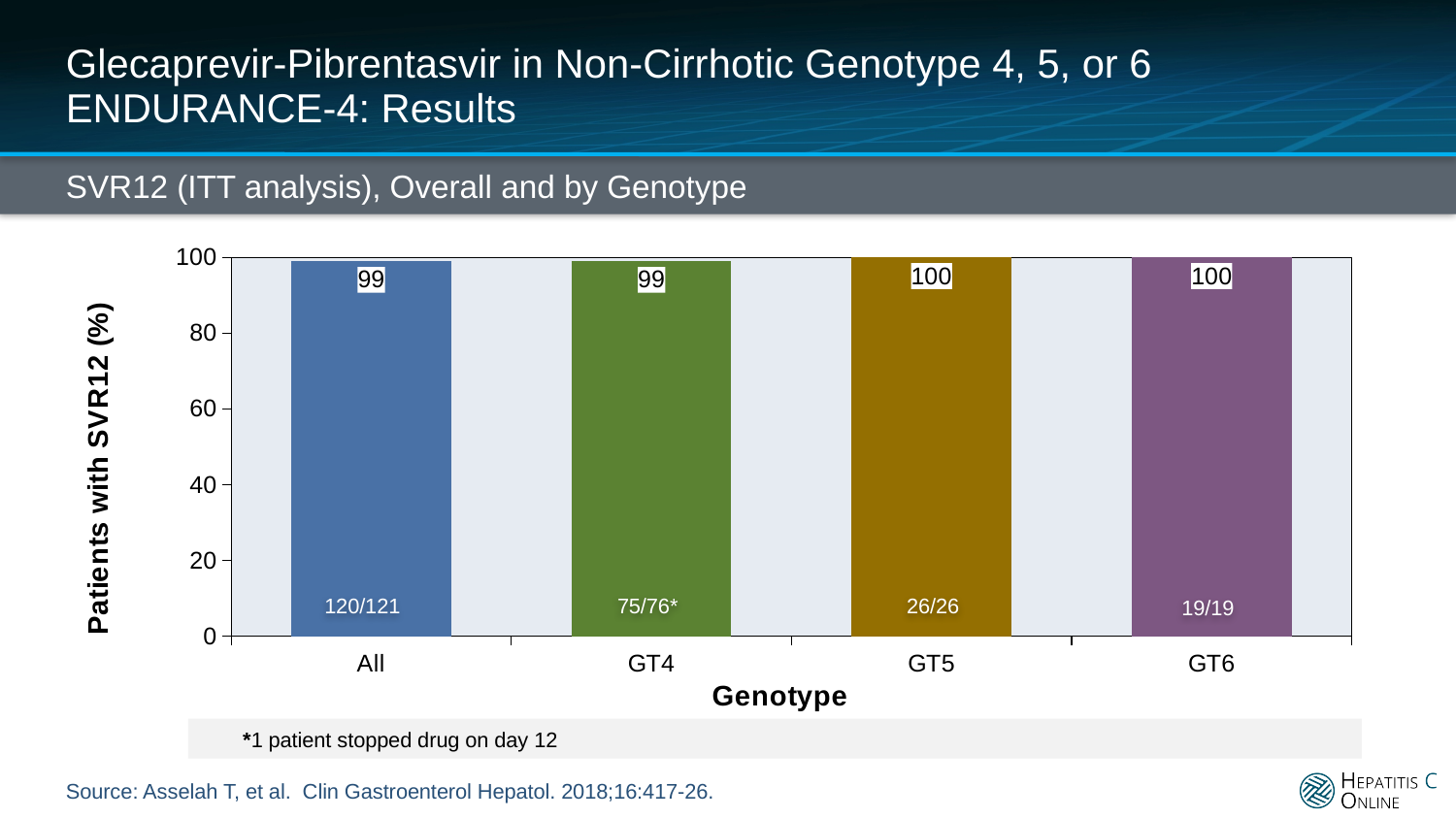
Is the SVR12 rate for GT4 greater or less than 80? greater What is the SVR12 rate for the All group? 99 How many genotype categories are shown on the x axis? 4 What is the label of the x axis? Genotype What fraction of patients is shown inside the GT4 bar? 75/76* What is the SVR12 rate for GT5? 100 Which has the higher SVR12 rate, GT4 or GT6? GT6 What is the label of the y axis? Patients with SVR12 (%) What is the SVR12 rate for GT6? 100 What is the difference between the SVR12 rate for GT5 and the SVR12 rate for GT4? 1 What fraction of patients is shown inside the All bar? 120/121 What kind of chart is shown on the slide? Bar chart